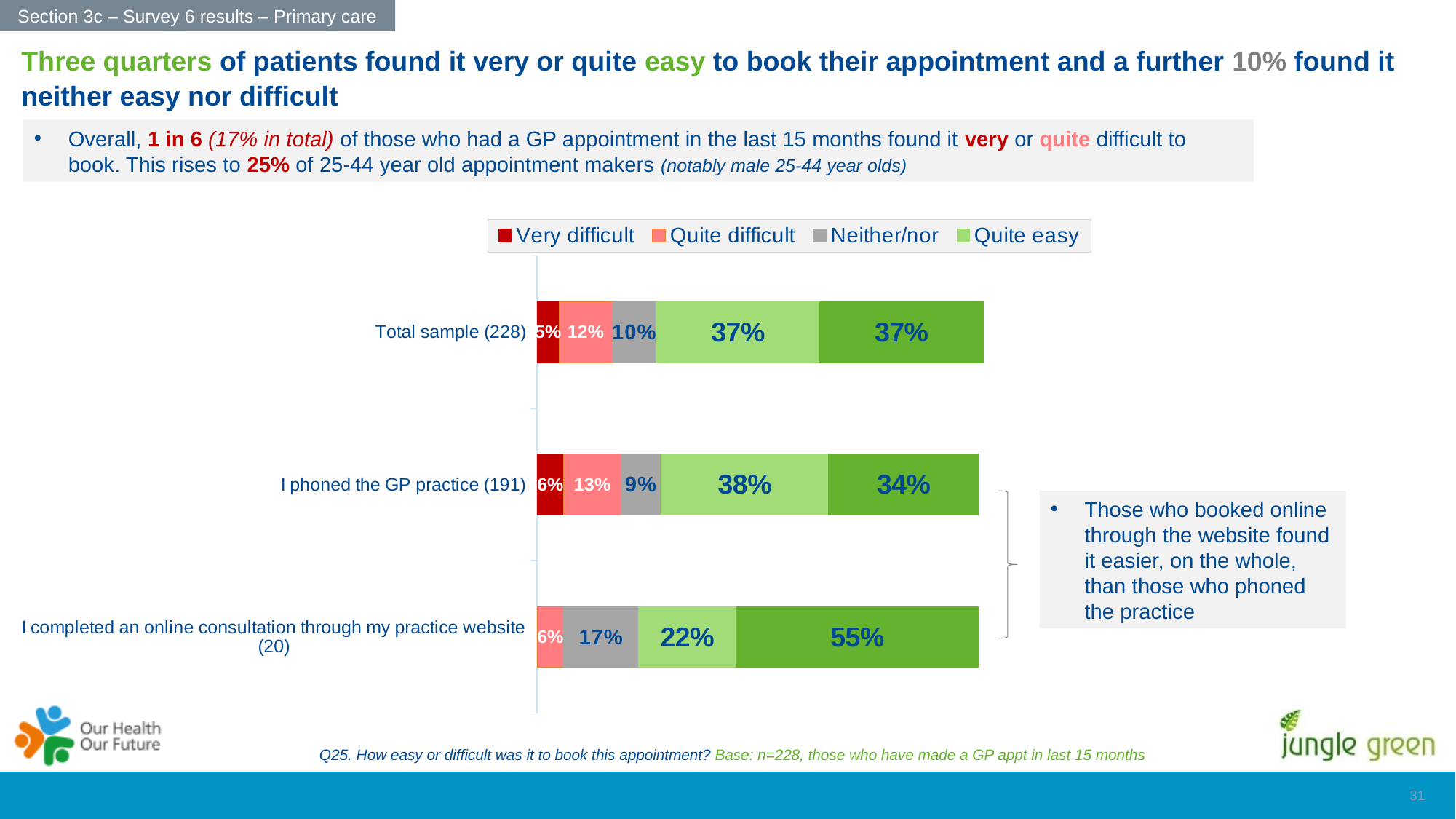
What is the difference between the Quite difficult values for 'I completed an online consultation through my practice website (20)' and the Total sample (228)? 6% Which is larger: the Quite easy value for 'I phoned the GP practice (191)' or for the Total sample (228)? I phoned the GP practice (191) Which category has the lowest Quite easy value? I completed an online consultation through my practice website (20) What is the Quite difficult value for 'I completed an online consultation through my practice website (20)'? 6% What is the Quite easy value for the Total sample (228)? 37% How many series does the chart legend list? 4 How many categories (bars) are plotted in the chart? 3 What type of chart is shown on the slide? Stacked bar chart What is the Very difficult value for 'I phoned the GP practice (191)'? 6% Which category has the highest Neither/nor value? I completed an online consultation through my practice website (20) What is the combined Very difficult and Quite difficult share for the Total sample (228)? 17% What is the Neither/nor value for 'I phoned the GP practice (191)'? 9%